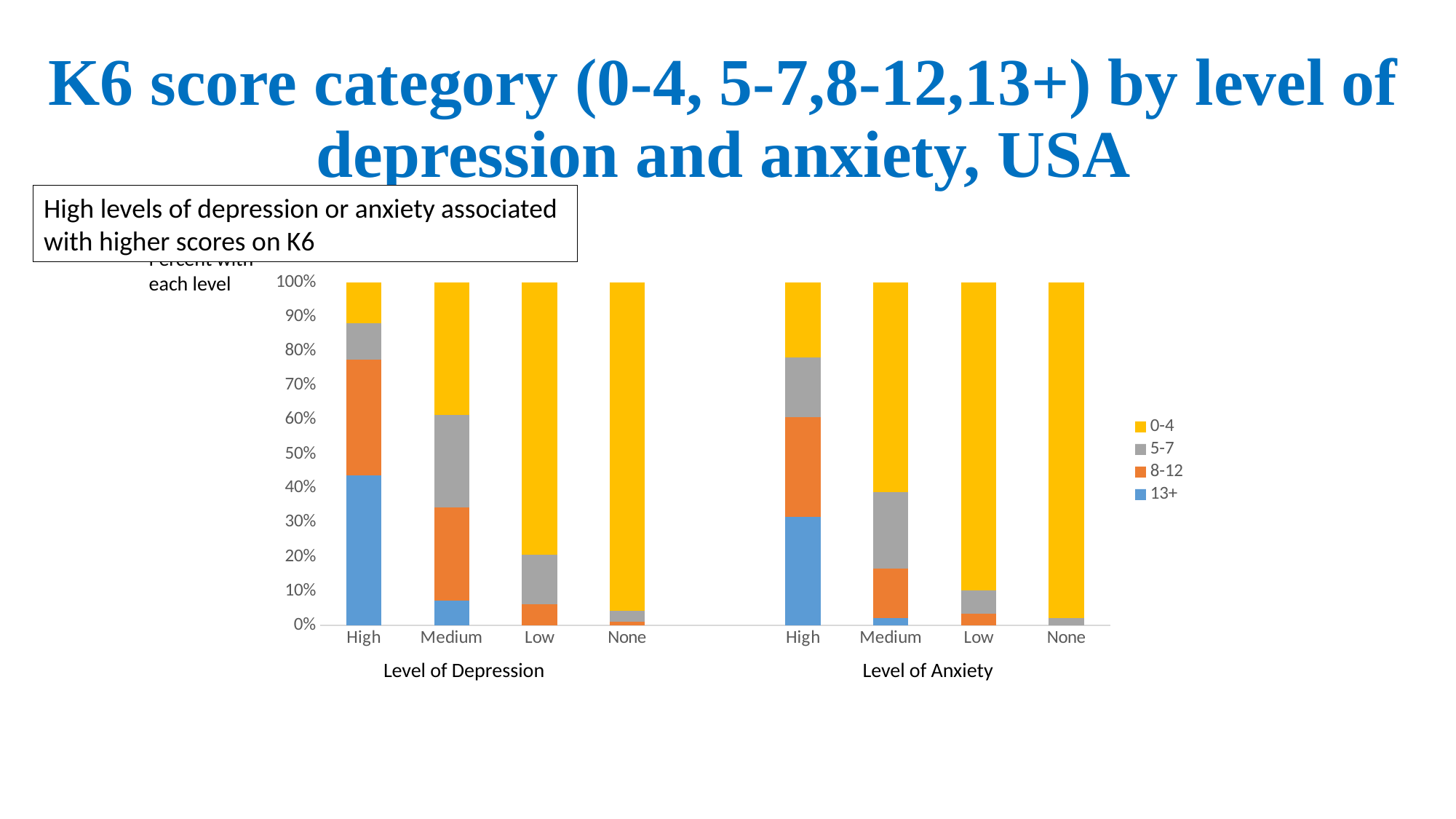
Is the 13+ share for High level of depression greater or less than 30%? greater Which has the larger 13+ share: High level of depression or High level of anxiety? High level of depression How many bars are plotted in the chart? 8 Is the 0-4 share for None level of depression greater or less than 90%? greater Is the 13+ share for Medium level of depression greater or less than 10%? less Within the Level of Depression group, does the 13+ share rise or fall from High to None? Fall Which colour represents the 0-4 K6 score category? Yellow What kind of chart is shown on the slide? Stacked bar chart What are the four K6 score categories listed in the legend? 0-4, 5-7, 8-12, 13+ How many series does the legend list? 4 Which bar has the largest 13+ segment? High (Level of Depression)